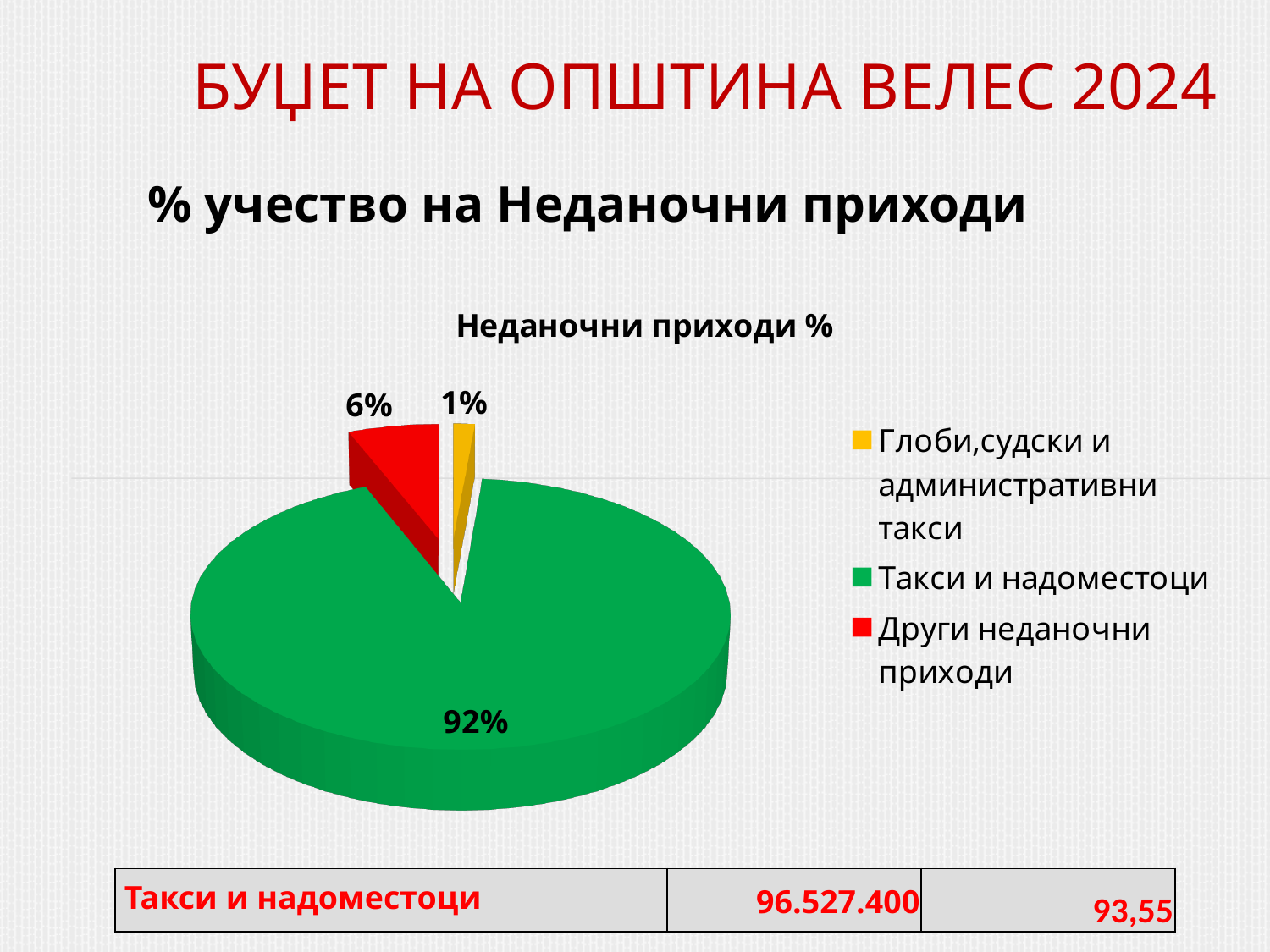
How many categories does the pie chart show? 3 What is the difference in percentage points between 'Други неданочни приходи' and 'Глоби,судски и административни такси'? 5 Which category has the smallest slice of the pie? Глоби,судски и административни такси What share of the pie does 'Такси и надоместоци' represent? 92% Which category has the largest slice of the pie? Такси и надоместоци What is the title of the chart? Неданочни приходи % What colour is the slice for 'Такси и надоместоци'? Green What type of chart is shown on the slide? Pie chart What share of the pie does 'Други неданочни приходи' represent? 6% What share of the pie does 'Глоби,судски и административни такси' represent? 1% What is the difference in percentage points between 'Такси и надоместоци' and 'Други неданочни приходи'? 86 Which is larger: the slice for 'Други неданочни приходи' or the slice for 'Глоби,судски и административни такси'? Други неданочни приходи